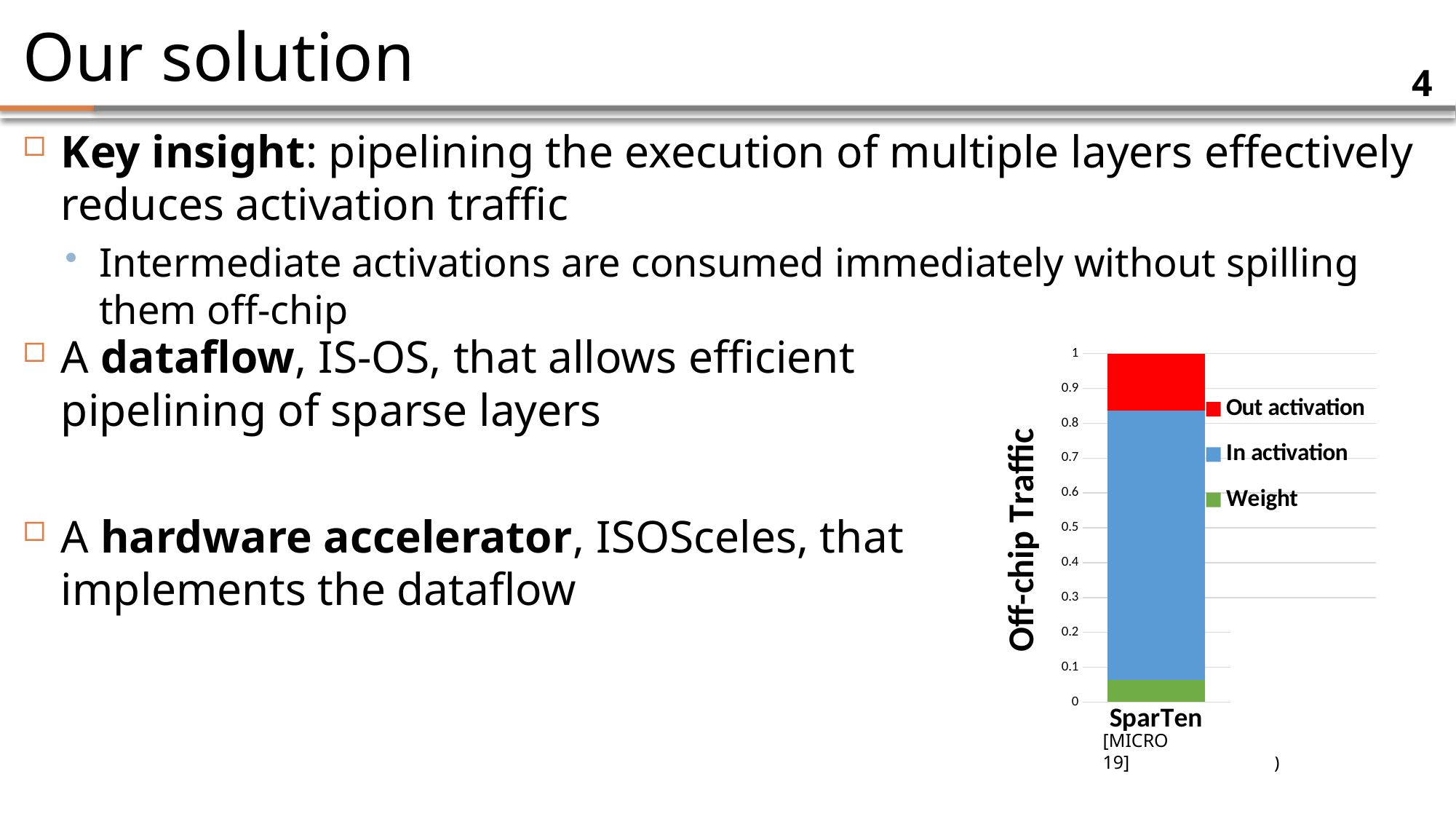
Which is larger for SparTen, the In activation segment or the Out activation segment? In activation How many categories are plotted on the x axis of the chart? 1 Which series makes up the largest portion of the SparTen bar? In activation What is the label of the y axis of the chart? Off-chip Traffic What is the total height of the stacked bar for SparTen? 1 How many series does the chart's legend list? 3 Is the Weight segment of the SparTen bar greater or less than 0.1? less Which series makes up the smallest portion of the SparTen bar? Weight What is the label of the single category on the x axis? SparTen Is the In activation segment of the SparTen bar greater or less than 0.5? greater What kind of chart is shown on the slide? bar chart Is the Out activation segment of the SparTen bar greater or less than 0.3? less